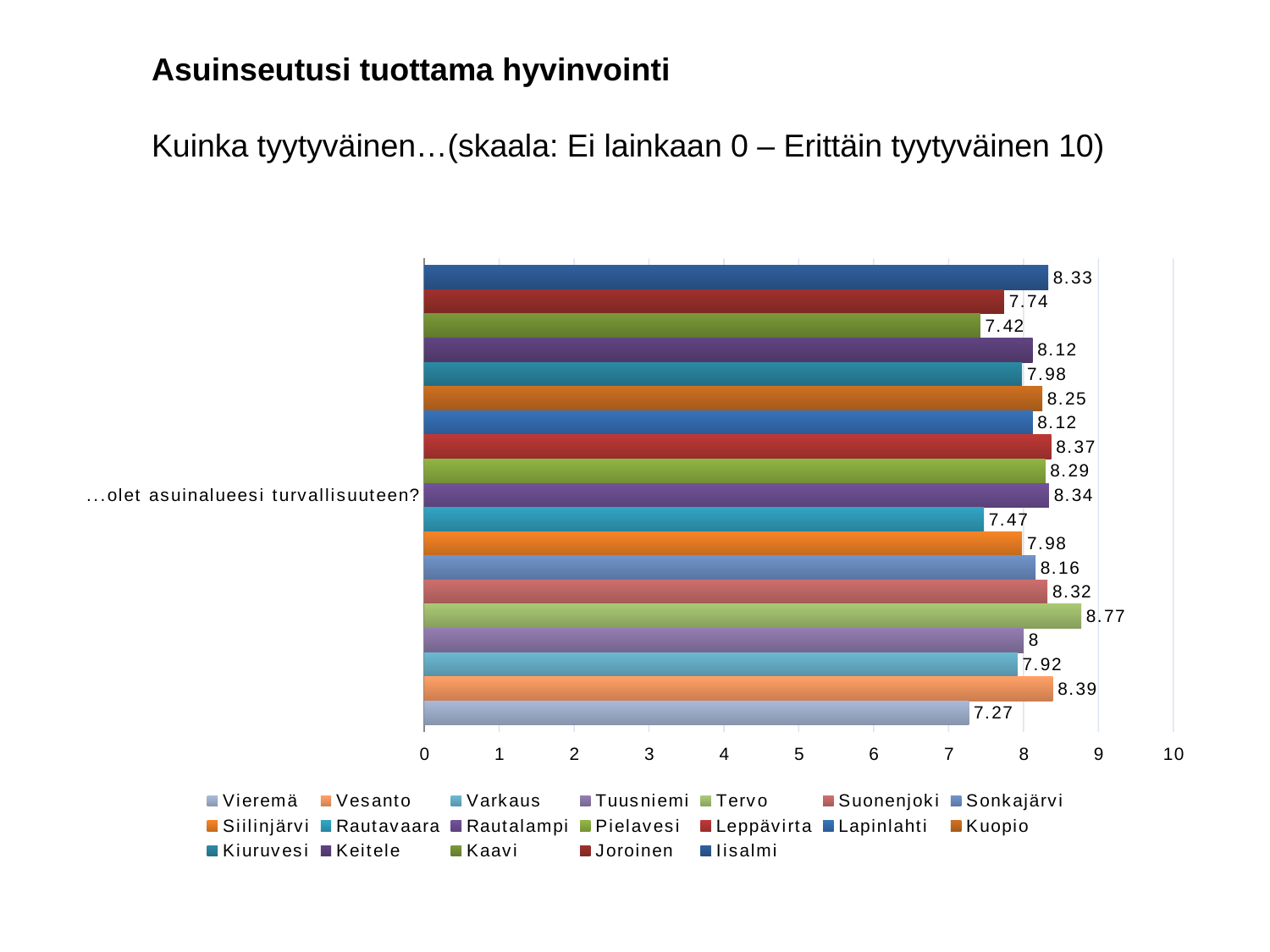
What is the difference between the values for Tervo and Vieremä? 1.5 What kind of chart is shown on the slide? bar chart What is the value for Kaavi? 7.42 What is the value for Iisalmi? 8.33 Which municipality has the lowest value? Vieremä How many series does the legend list? 19 What is the value for Tervo? 8.77 What is the category label shown on the vertical axis? ...olet asuinalueesi turvallisuuteen? Which is larger, the value for Vesanto or the value for Joroinen? Vesanto What is the value for Vieremä? 7.27 Which municipality has the highest value? Tervo Is the value for Rautavaara greater or less than 8? less